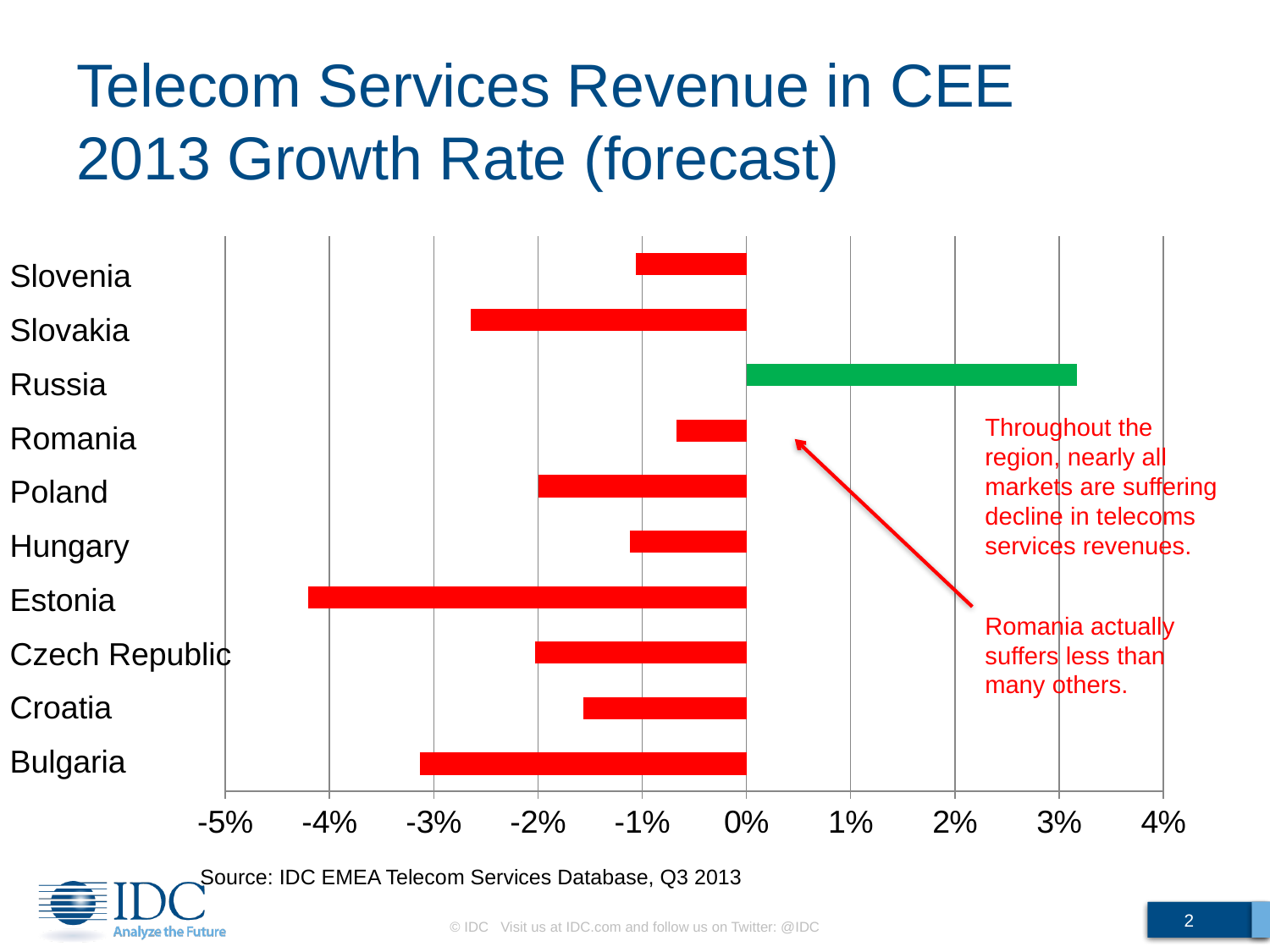
Is the value for Russia greater or less than 3%? greater Is the value for Estonia greater or less than -4%? less What kind of chart is shown on the slide? Bar chart What colour is the bar for Russia? Green Which country has the highest 2013 growth rate forecast? Russia How many countries are plotted in the chart? 10 How many countries in the chart show a positive growth rate? 1 Is the value for Slovakia greater or less than -2%? less Which country has the lowest 2013 growth rate forecast? Estonia Which country has the larger (less negative) growth rate, Slovakia or Bulgaria? Slovakia